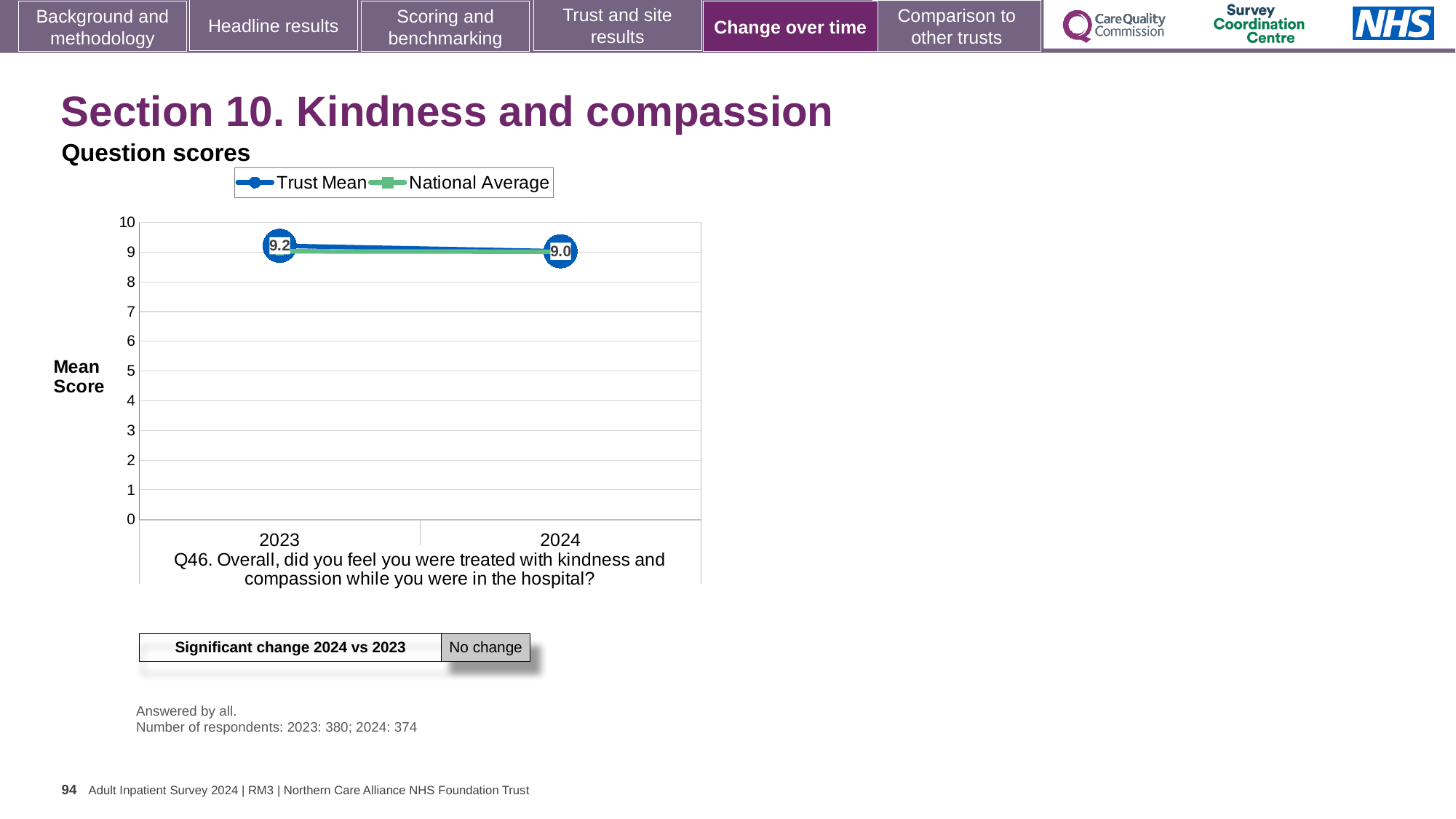
What kind of chart is shown on the slide? line chart What are the two series named in the chart legend? Trust Mean and National Average Is the National Average value for 2024 greater or less than 5? greater In which year is the Trust Mean score highest? 2023 How many years are shown on the x axis of the chart? 2 In which year is the Trust Mean score lowest? 2024 Does the Trust Mean score rise or fall from 2023 to 2024? fall What is the Trust Mean score for 2024? 9.0 What is the Trust Mean score for 2023? 9.2 What is the difference between the Trust Mean score in 2023 and in 2024? 0.2 Which is larger, the Trust Mean score for 2023 or for 2024? 2023 How many series does the chart legend list? 2